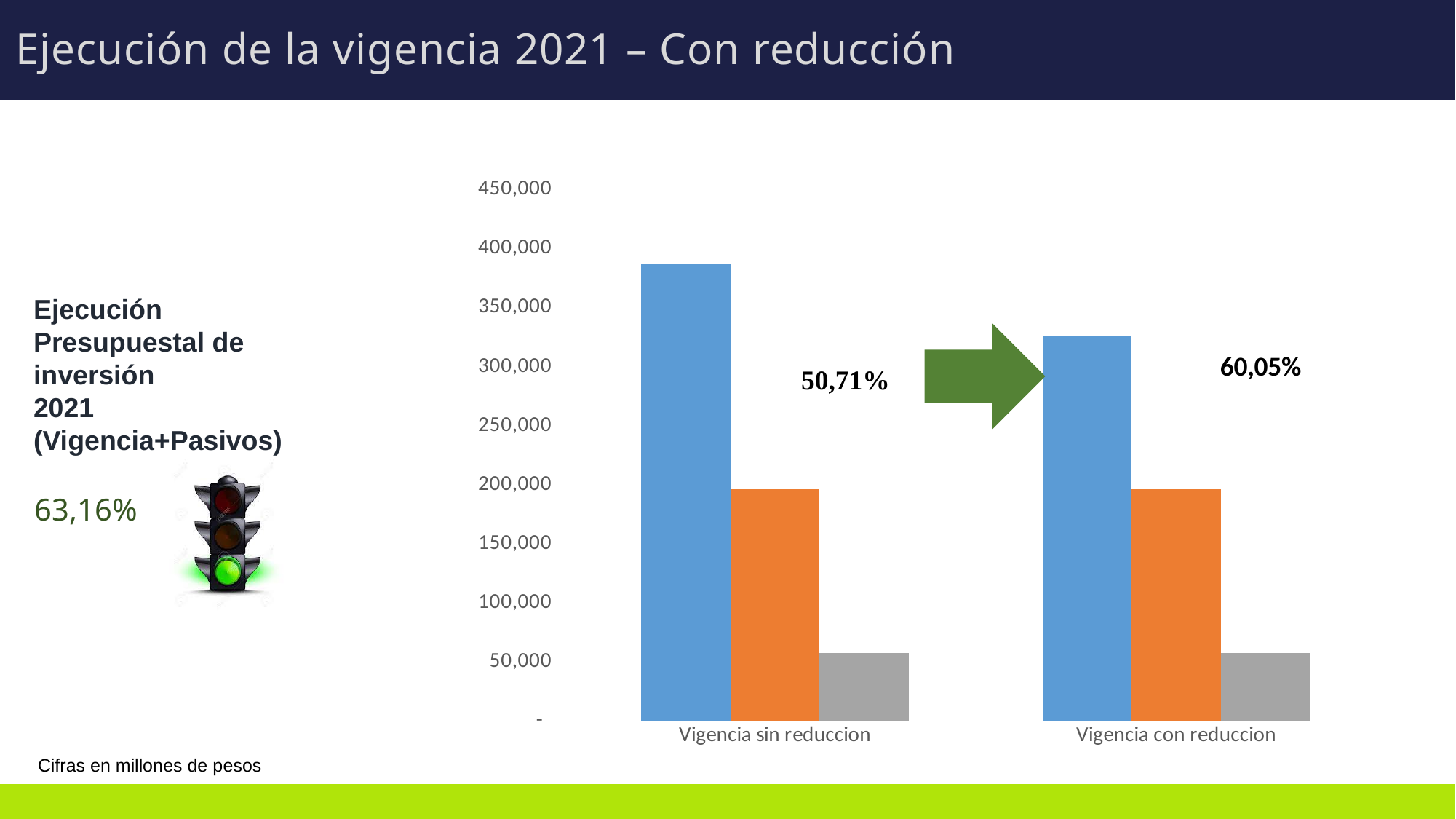
Does the blue bar rise or fall from Vigencia sin reduccion to Vigencia con reduccion? fall What percentage is printed next to the Vigencia con reduccion bars? 60,05% Is the blue bar for Vigencia sin reduccion greater or less than 350,000? greater Is the gray bar for Vigencia con reduccion greater or less than 100,000? less How many categories are shown on the x axis of the chart? 2 Is the orange bar for Vigencia con reduccion greater or less than 250,000? less Which coloured bar is the lowest in the Vigencia sin reduccion group? gray Which category has the taller blue bar, Vigencia sin reduccion or Vigencia con reduccion? Vigencia sin reduccion What percentage is printed next to the Vigencia sin reduccion bars? 50,71% What kind of chart is shown on the slide? bar chart